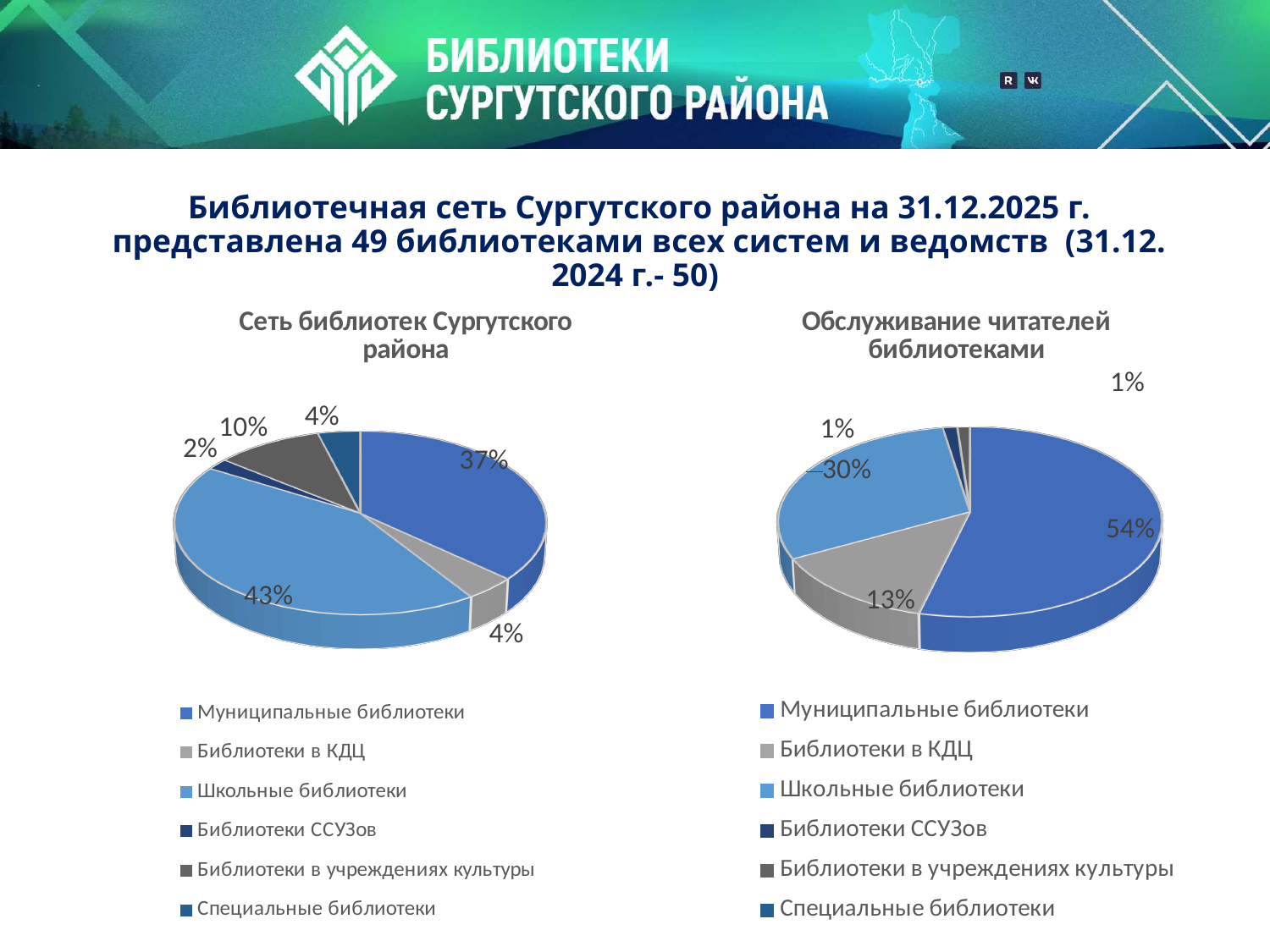
On the left chart 'Сеть библиотек Сургутского района', what share do Библиотеки ССУЗов have? 2% What type of chart is used on the left chart 'Сеть библиотек Сургутского района'? Pie chart On the left chart 'Сеть библиотек Сургутского района', what share do Библиотеки в учреждениях культуры have? 10% On the right chart 'Обслуживание читателей библиотеками', what share do Школьные библиотеки have? 30% On the right chart 'Обслуживание читателей библиотеками', what share do Муниципальные библиотеки have? 54% On the left chart 'Сеть библиотек Сургутского района', what share do Школьные библиотеки have? 43% On the right chart 'Обслуживание читателей библиотеками', what share do Библиотеки в КДЦ have? 13% How many categories does the legend of the right chart 'Обслуживание читателей библиотеками' list? 6 On the left chart 'Сеть библиотек Сургутского района', what share do Муниципальные библиотеки have? 37% On the right chart 'Обслуживание читателей библиотеками', what is the difference between the shares of Муниципальные библиотеки and Школьные библиотеки? 24% On the left chart 'Сеть библиотек Сургутского района', which category has the smallest share? Библиотеки ССУЗов On the left chart 'Сеть библиотек Сургутского района', which category has the largest share? Школьные библиотеки